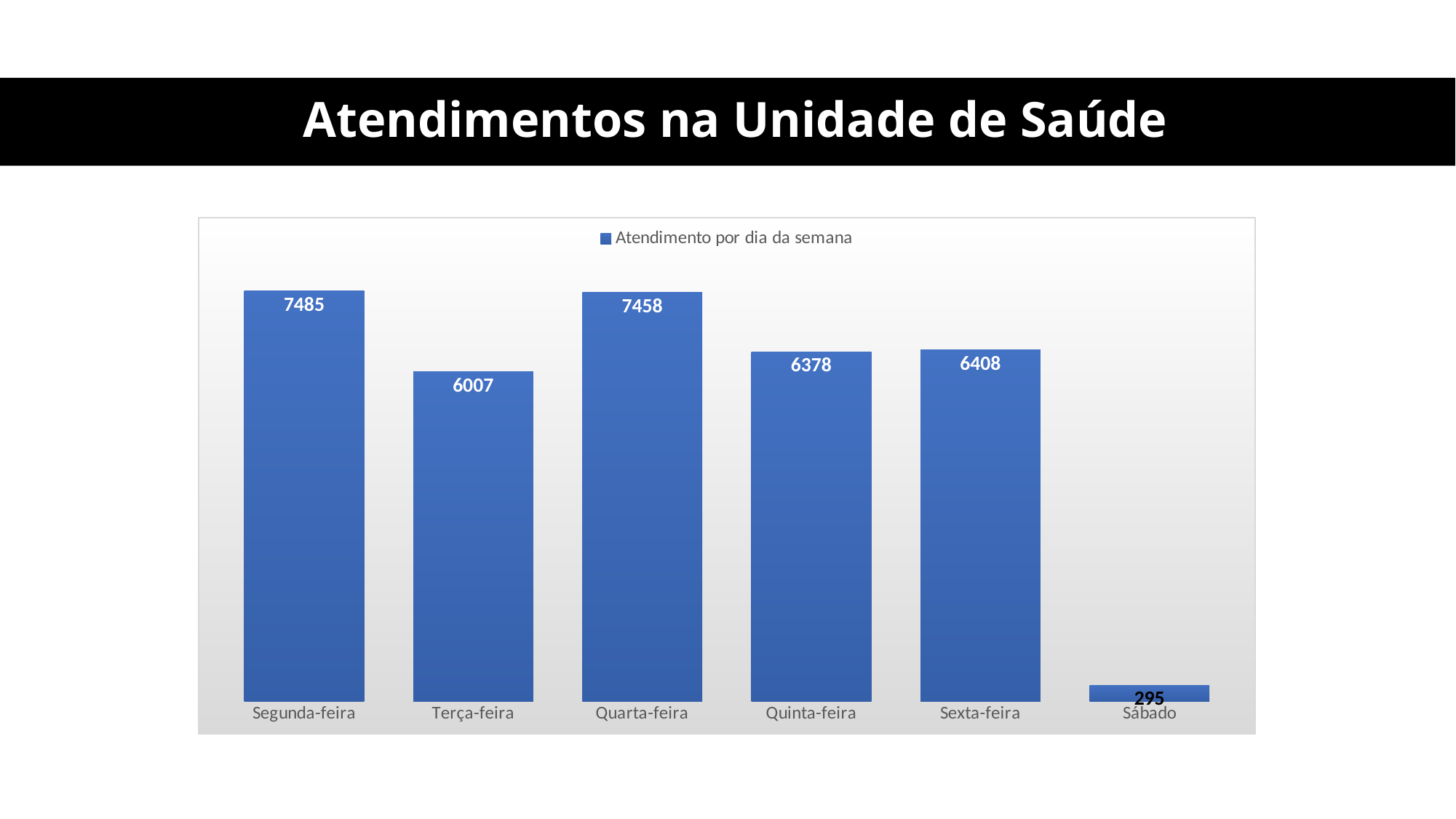
What is the legend entry of the chart? Atendimento por dia da semana Which day has the lowest value? Sábado How many series does the legend list? 1 What is the value for Terça-feira? 6007 Which day has the highest value? Segunda-feira Which is larger, the value for Quarta-feira or the value for Quinta-feira? Quarta-feira What is the value for Sábado? 295 What is the difference between the values for Sexta-feira and Quinta-feira? 30 What kind of chart is shown on the slide? Bar chart How many days are shown on the x axis? 6 What is the difference between the values for Segunda-feira and Terça-feira? 1478 What is the value for Segunda-feira? 7485